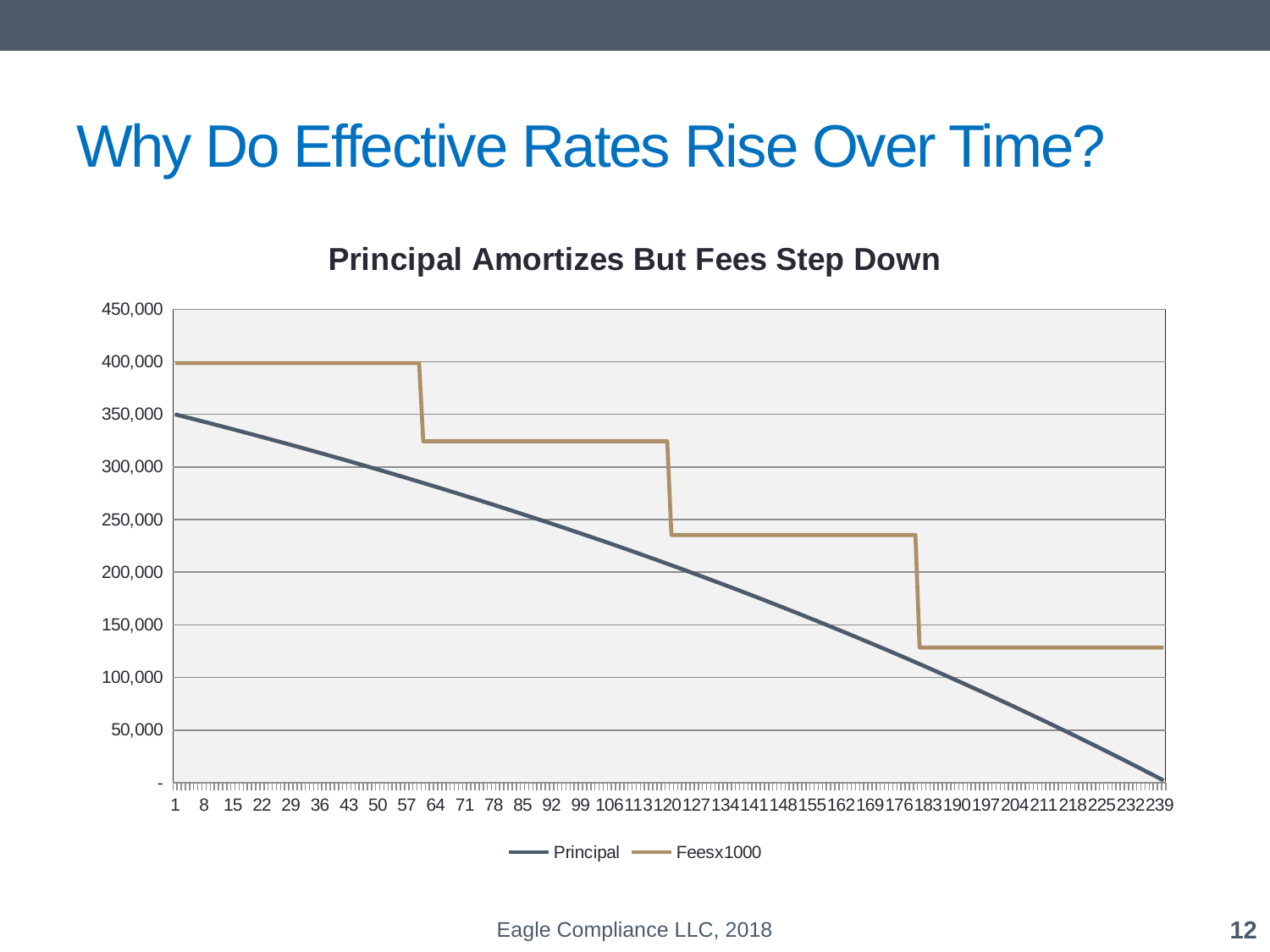
At period 1, which series has the higher value, Principal or Feesx1000? Feesx1000 Does the Principal series rise or fall as the x axis increases? fall Is the value of Feesx1000 at period 239 greater or less than 150,000? less At period 239, which series has the higher value, Principal or Feesx1000? Feesx1000 Does the Feesx1000 series rise or fall over the x axis? fall What is the title of the chart? Principal Amortizes But Fees Step Down What is the value of Principal at period 1? 350,000 Is the value of Principal at period 239 greater or less than 50,000? less What are the two series named in the legend? Principal and Feesx1000 How many series does the legend list? 2 What kind of chart is shown on the slide? line chart